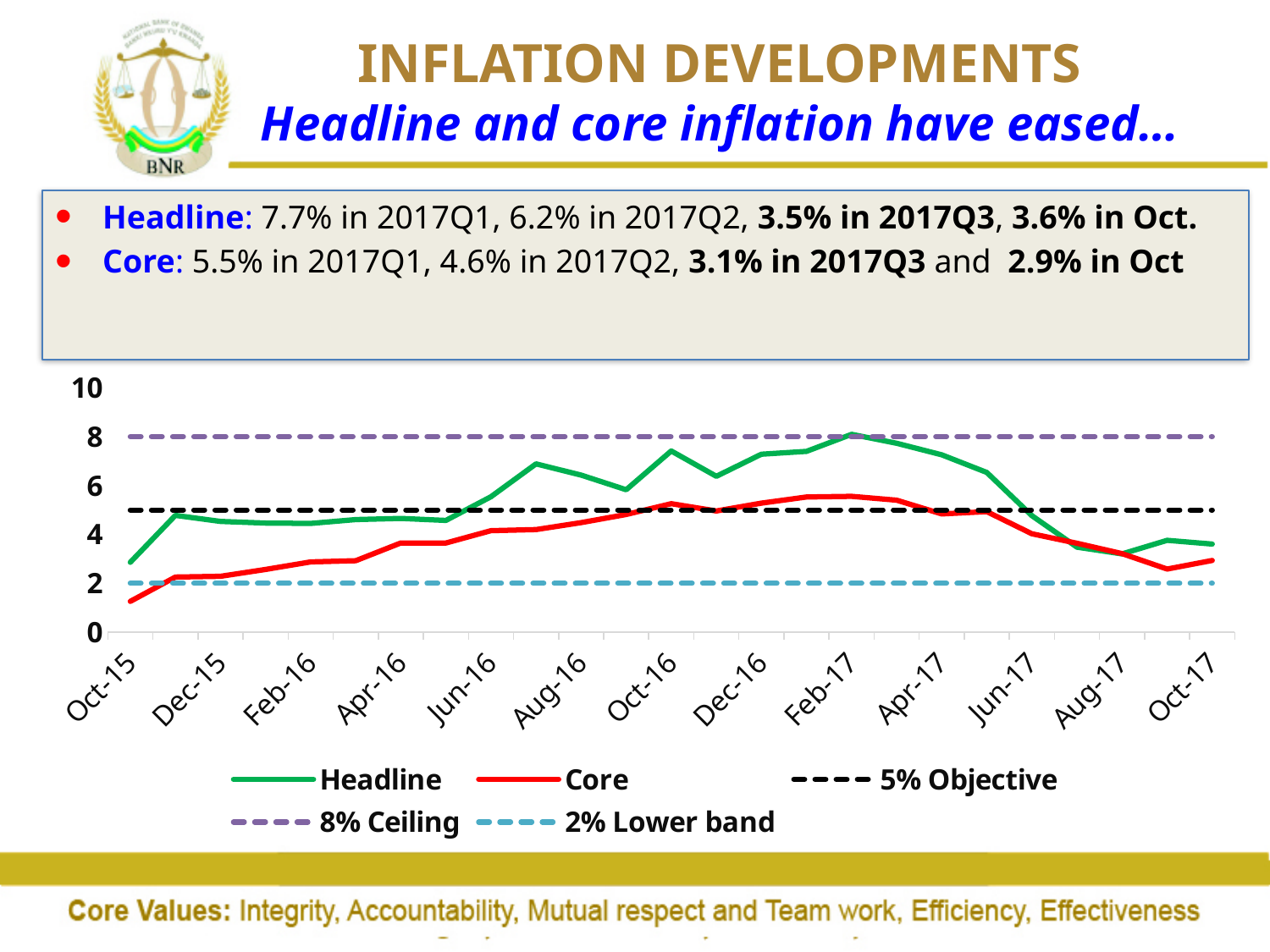
Is the Core value at Oct-15 greater or less than 2? less Is the Headline value at Oct-15 greater or less than 4? less What kind of chart is shown on the slide? Line chart What colour is the Core line in the chart? Red At which month is the Core series at its lowest value? Oct-15 Does the Headline series rise or fall between Feb-17 and Oct-17? Fall How many series does the chart legend list? 5 Is the Core value at Oct-17 greater or less than 4? less At Feb-17, which is larger, Headline or Core inflation? Headline Around which month does the Headline series reach its peak? Feb-17 Which series reaches the highest value on the chart? Headline